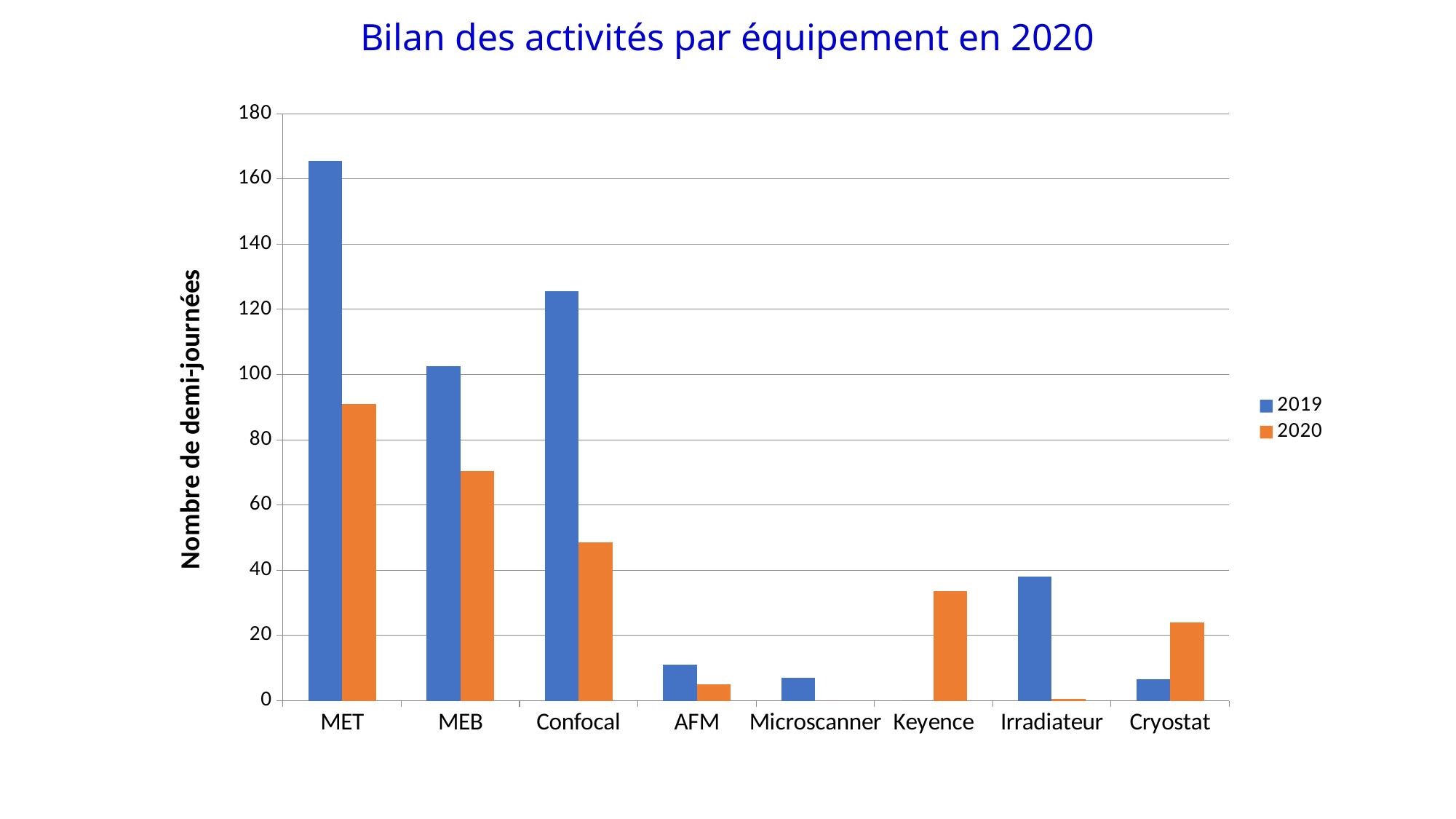
Which equipment has the highest value for 2019? MET How many equipment categories are shown on the x axis? 8 What is the label of the vertical axis? Nombre de demi-journées How many series does the legend list? 2 For Cryostat, which year has the larger value, 2019 or 2020? 2020 Which equipment has the highest value for 2020? MET What kind of chart is shown on the slide? bar chart Is the 2019 value for MET greater or less than 160? greater Is the 2020 value for Confocal greater or less than 60? less Which has the larger 2019 value, MEB or Confocal? Confocal Is the 2020 value for Keyence greater or less than 20? greater Which equipment has the lowest value for 2019? Keyence